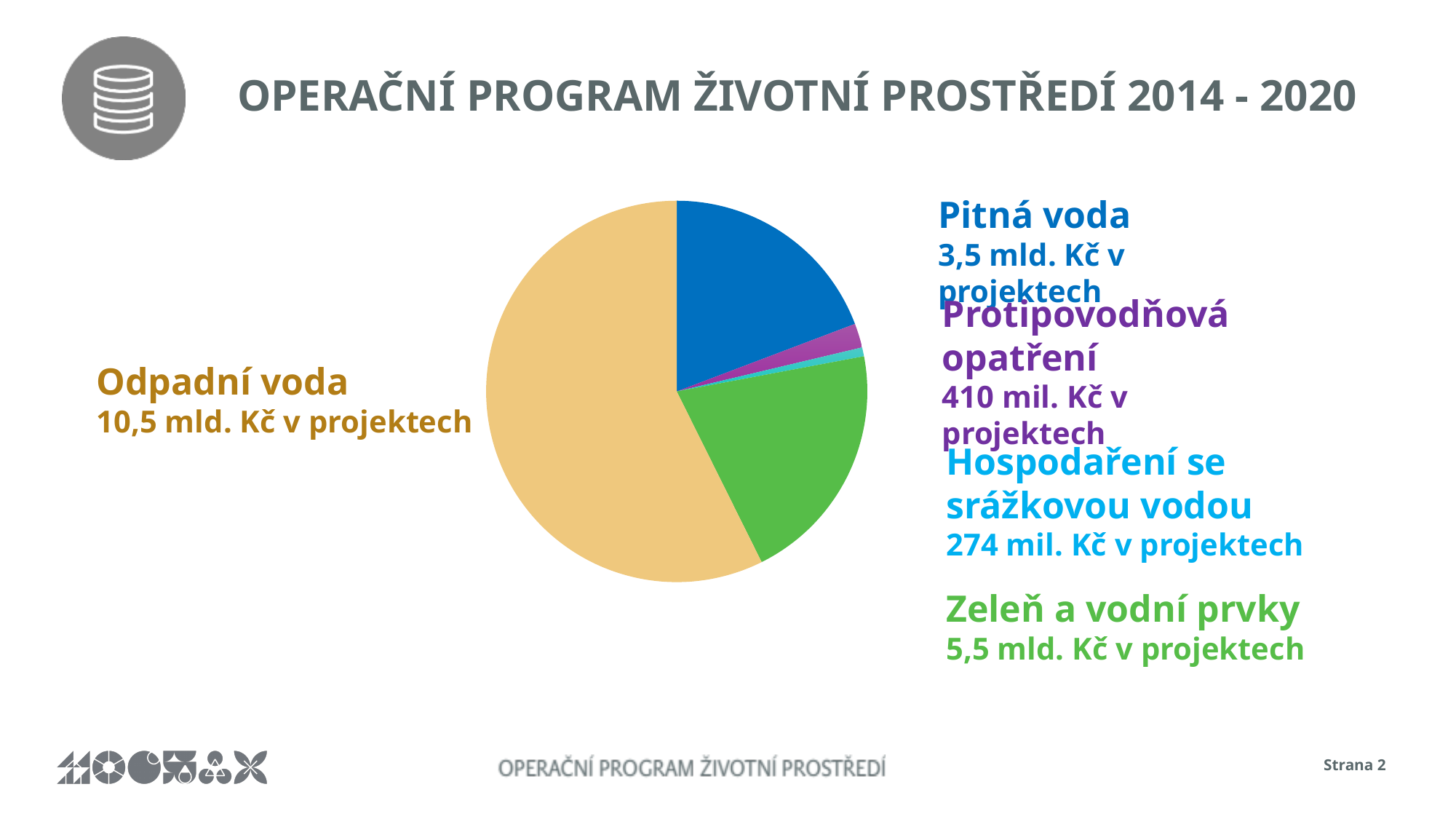
What kind of chart is shown on the slide? pie chart What is the difference between the values for Odpadní voda and Zeleň a vodní prvky? 5 mld. Kč Which is larger, the value for Zeleň a vodní prvky or the value for Pitná voda? Zeleň a vodní prvky What colour is the slice for Odpadní voda in the pie chart? tan (beige) What is the value shown for Hospodaření se srážkovou vodou? 274 mil. Kč What is the value shown for Protipovodňová opatření? 410 mil. Kč How many slices does the pie chart have? 5 What is the value shown for Odpadní voda? 10,5 mld. Kč What is the value shown for Pitná voda? 3,5 mld. Kč Which category has the largest slice of the pie chart? Odpadní voda Which category has the smallest slice of the pie chart? Hospodaření se srážkovou vodou What is the value shown for Zeleň a vodní prvky? 5,5 mld. Kč